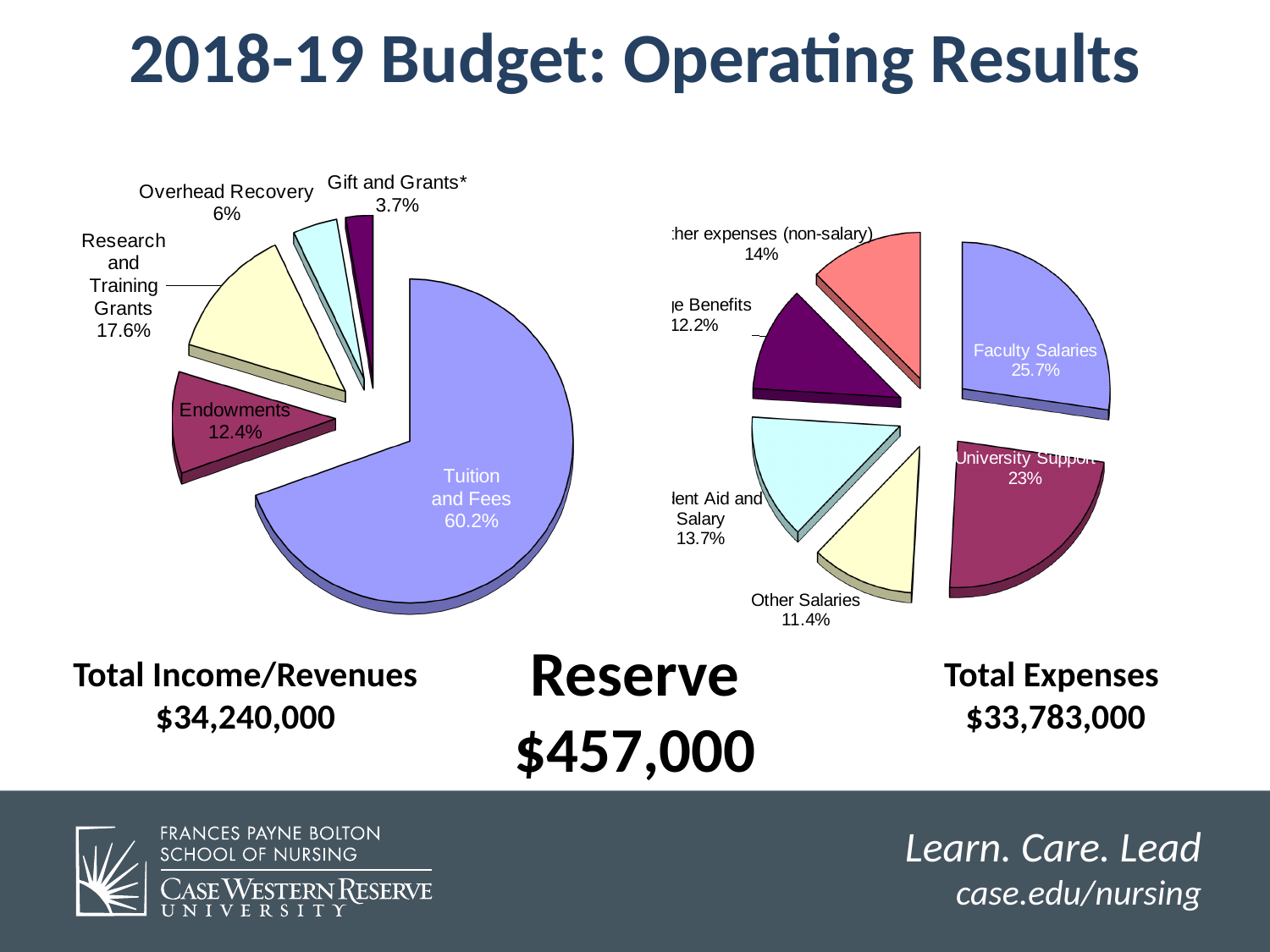
In the Total Expenses pie chart on the right, what share is Faculty Salaries? 25.7% In the Total Expenses pie chart on the right, which category has the largest share? Faculty Salaries In the Total Expenses pie chart on the right, what share is University Support? 23% How many slices does the Total Income/Revenues pie chart on the left have? 5 In the Total Income/Revenues pie chart on the left, what is the difference in percentage points between Research and Training Grants and Endowments? 5.2 percentage points In the Total Income/Revenues pie chart on the left, which is larger: Overhead Recovery or Gift and Grants*? Overhead Recovery How many slices does the Total Expenses pie chart on the right have? 6 In the Total Expenses pie chart on the right, what is the difference in percentage points between Faculty Salaries and University Support? 2.7 percentage points What type of chart is used for the Total Expenses chart on the right? Pie chart In the Total Income/Revenues pie chart on the left, which category has the smallest share? Gift and Grants* In the Total Income/Revenues pie chart on the left, which category has the largest share? Tuition and Fees In the Total Income/Revenues pie chart on the left, what share is Tuition and Fees? 60.2%